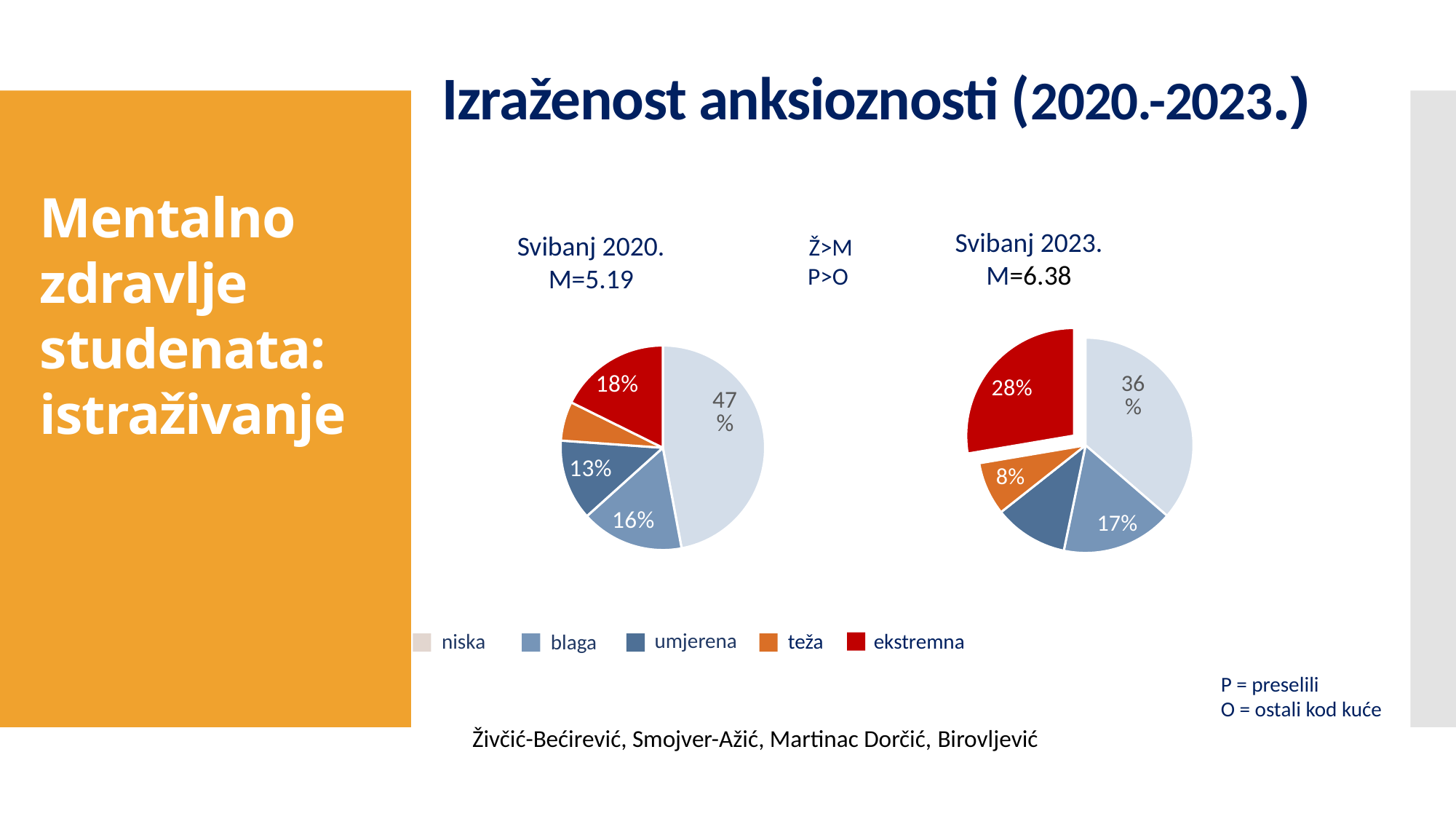
Is the ekstremna slice larger in the Svibanj 2020. pie chart or in the Svibanj 2023. pie chart? Svibanj 2023. How many categories does the legend list for the pie charts? 5 In the Svibanj 2023. pie chart, what share is labelled for the teža category? 8% In the Svibanj 2020. pie chart, what share is labelled for the umjerena category? 13% What kind of chart is used to show the Svibanj 2020. and Svibanj 2023. data? Pie chart Which colour represents the ekstremna category in the pie charts? Red In the Svibanj 2020. pie chart, which category has the largest slice? niska In the Svibanj 2020. pie chart, which category has the smallest slice? teža In the Svibanj 2020. pie chart, what is the difference in percentage points between the niska slice and the ekstremna slice? 29 percentage points In the Svibanj 2020. pie chart, what share is labelled for the niska category? 47% In the Svibanj 2023. pie chart, which category has the largest slice? niska In the Svibanj 2023. pie chart, what share is labelled for the ekstremna category? 28%